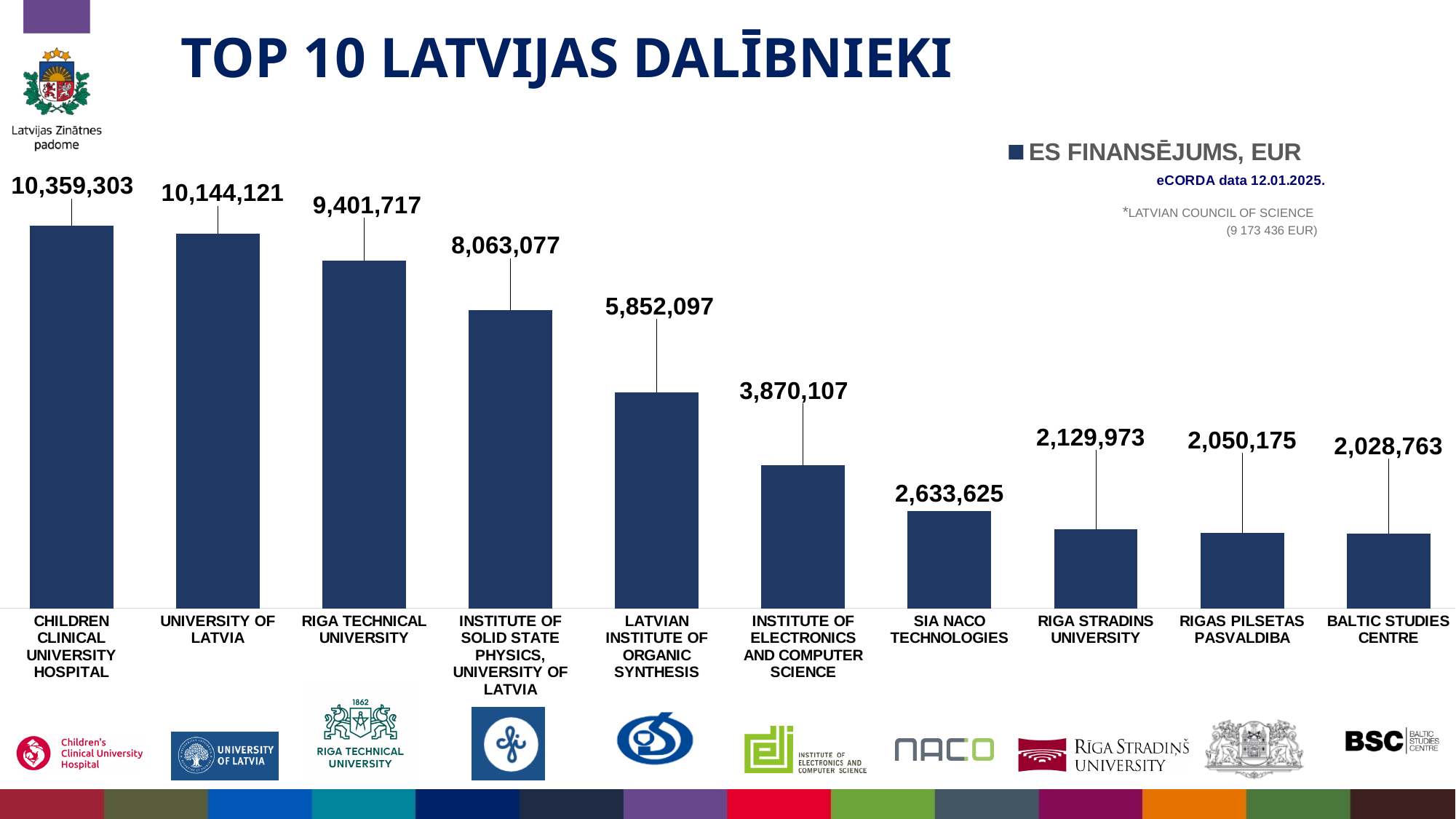
How many categories are shown in the chart? 10 How many series does the legend list? 1 What is the ES financing value for Riga Technical University? 9,401,717 Do the values rise or fall from left to right along the x axis? Fall Which category has the lowest value in the chart? Baltic Studies Centre What is the value shown for SIA NACO Technologies? 2,633,625 Which category has the highest value in the chart? Children Clinical University Hospital What is the difference between the values for Institute of Solid State Physics, University of Latvia and Latvian Institute of Organic Synthesis? 2,210,980 What is the value shown for Latvian Institute of Organic Synthesis? 5,852,097 What kind of chart is shown on the slide? Bar chart What is the difference between the values for Children Clinical University Hospital and University of Latvia? 215,182 Which has a larger value: Riga Stradins University or Rigas Pilsetas Pasvaldiba? Riga Stradins University